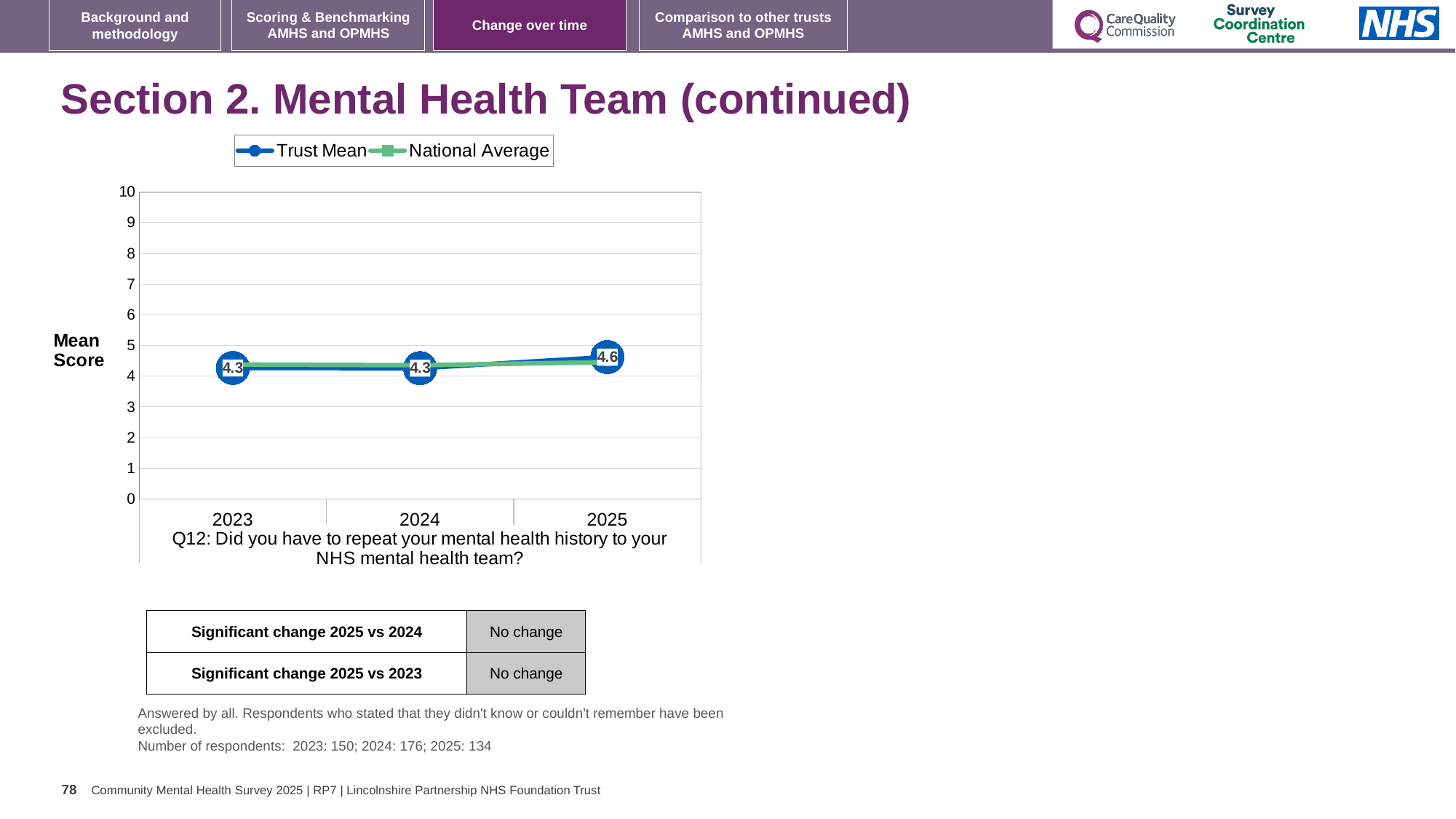
What is the difference between the Trust Mean score in 2025 and in 2023? 0.3 Is the National Average value for 2025 greater or less than 5? less What is the Trust Mean score for 2024? 4.3 What is the Trust Mean score for 2023? 4.3 Does the Trust Mean rise or fall from 2024 to 2025? Rise In which year is the Trust Mean score highest? 2025 Is the Trust Mean score larger in 2025 or in 2024? 2025 What kind of chart is shown on the slide? Line chart What is the label on the y axis of the chart? Mean Score What is the Trust Mean score for 2025? 4.6 How many series does the legend list? 2 How many years are plotted on the x axis? 3